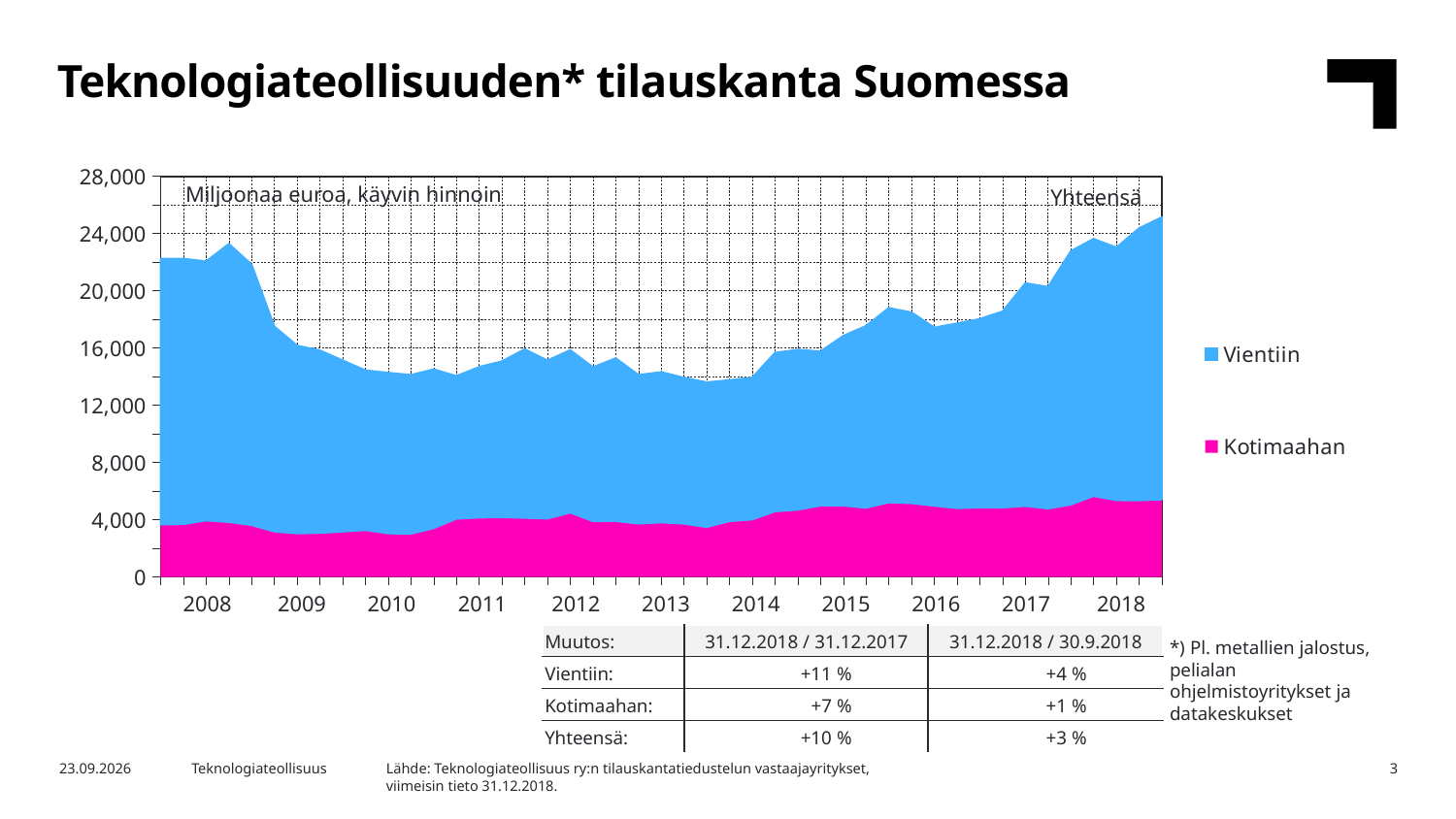
How many year labels are shown on the x axis? 11 How many series does the chart legend list? 2 What are the two series named in the chart legend? Vientiin and Kotimaahan Which is larger, the total (Yhteensä) value in 2018 or in 2013? 2018 Is the total (Yhteensä) value at the end of 2018 greater or less than 24,000? greater What unit label is printed inside the chart area? Miljoonaa euroa, käyvin hinnoin Is the Kotimaahan value in 2018 greater or less than 8,000? less Is the total (Yhteensä) value in 2013 greater or less than 16,000? less What kind of chart is shown on the slide? Stacked area chart Does the total (Yhteensä) value rise or fall from 2016 to 2018? rise